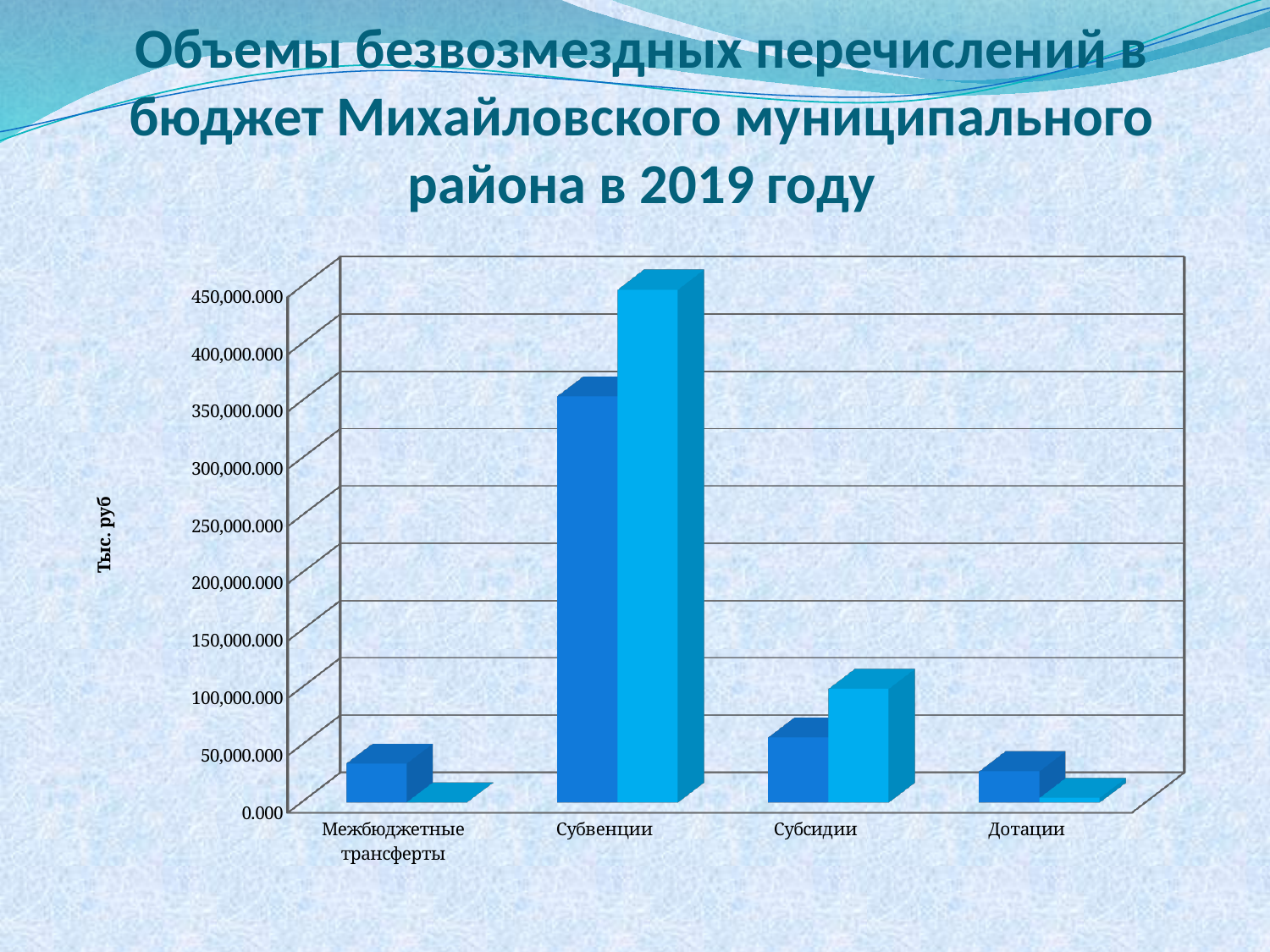
Is the value of the darker blue bar for Дотации greater or less than 50,000.000? less Is the value of the darker blue bar for Субвенции greater or less than 300,000.000? greater Is the value of the lighter blue bar for Субвенции greater or less than 400,000.000? greater What is the title of the slide containing the chart? Объемы безвозмездных перечислений в бюджет Михайловского муниципального района в 2019 году What kind of chart is shown on the slide? bar chart For Субсидии, which bar is taller, the darker blue one or the lighter blue one? the lighter blue one How many categories are shown on the x axis of the chart? 4 What is the label on the vertical axis of the chart? Тыс. руб Which category has the highest bars in the chart? Субвенции Which category has larger bars, Субвенции or Субсидии? Субвенции